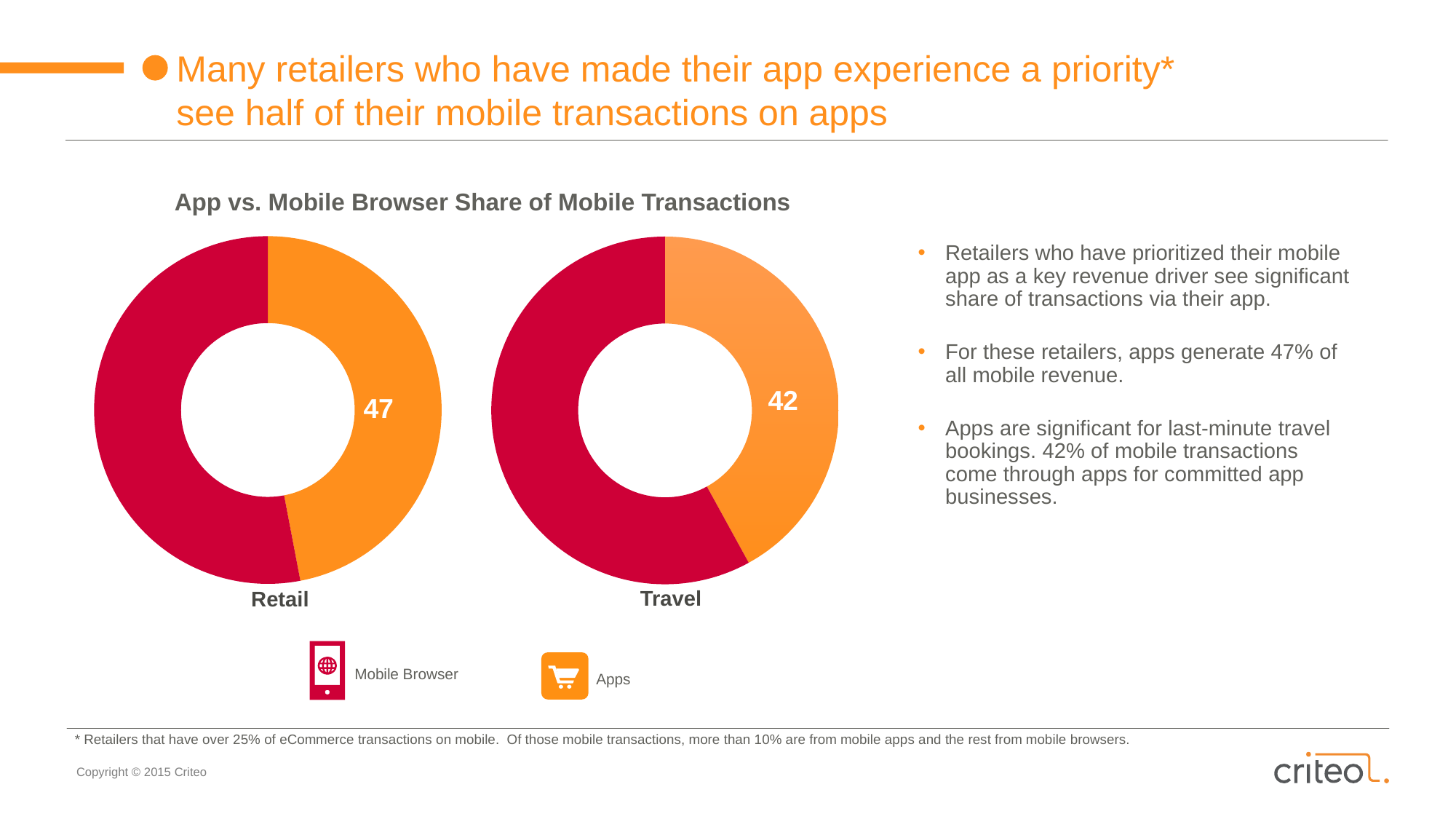
Which legend entry is shown in orange? Apps In the Travel donut chart, what value is shown for Apps? 42 What is the difference between the Apps value in the Retail chart and the Apps value in the Travel chart? 5 In the Travel chart, which segment is larger, Mobile Browser or Apps? Mobile Browser In the Travel chart, what share of mobile transactions is attributed to Apps? 42 How many series does the legend list for the charts? 2 How many donut charts are shown on the slide? 2 In the Retail chart, which segment is larger, Mobile Browser or Apps? Mobile Browser What kind of chart is used to show the Retail and Travel data? Pie (donut) chart Which chart shows the larger Apps share, Retail or Travel? Retail What is the title of the chart section on the slide? App vs. Mobile Browser Share of Mobile Transactions In the Retail donut chart, what value is shown for Apps? 47